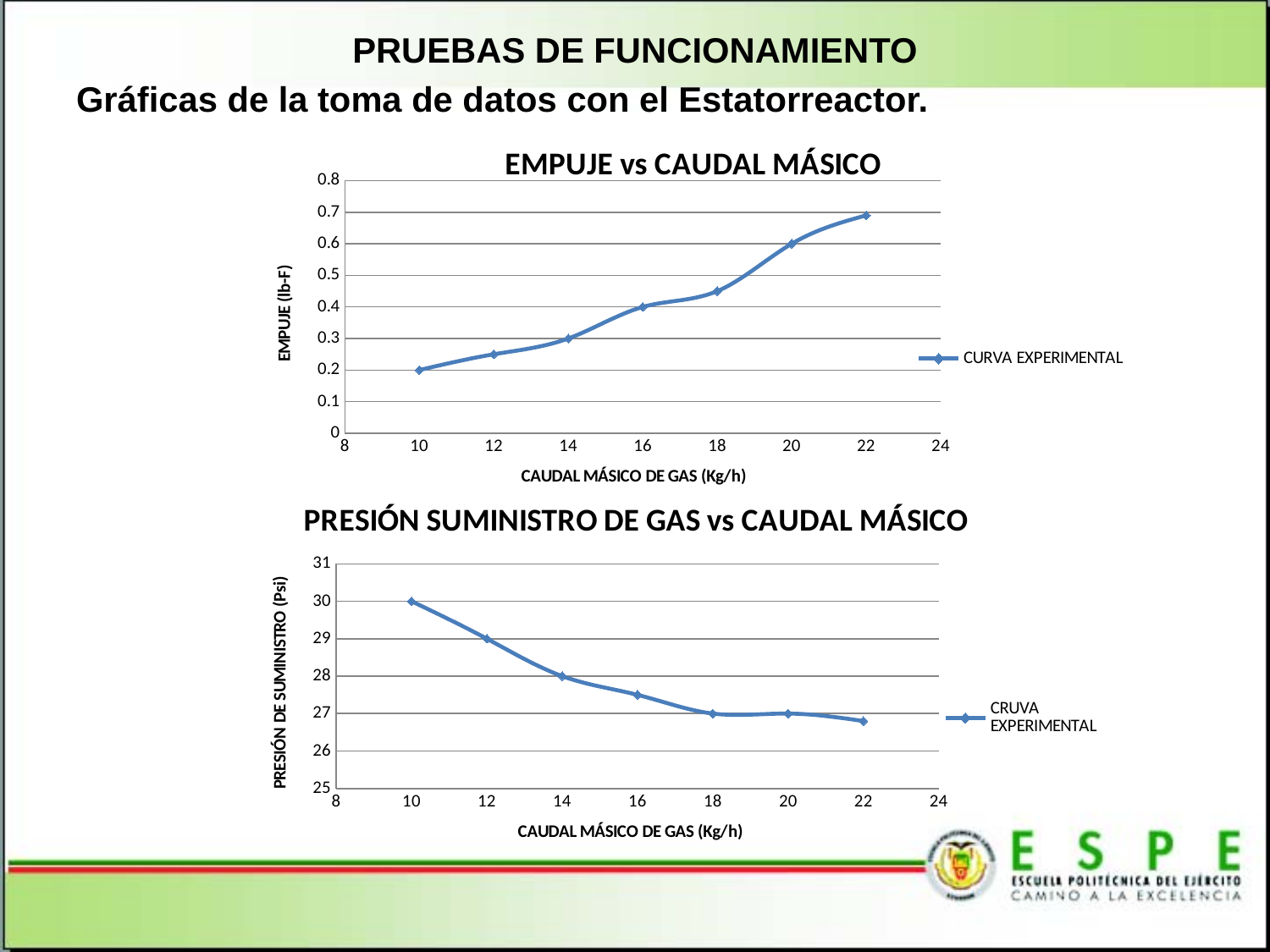
In the EMPUJE vs CAUDAL MÁSICO chart, is the value at 22 Kg/h greater or less than 0.6? greater In the EMPUJE vs CAUDAL MÁSICO chart, what is the EMPUJE value at a caudal másico of 10 Kg/h? 0.2 In the PRESIÓN SUMINISTRO DE GAS vs CAUDAL MÁSICO chart, how many series does the legend list? 1 In the EMPUJE vs CAUDAL MÁSICO chart, what type of chart is shown? line chart In the PRESIÓN SUMINISTRO DE GAS vs CAUDAL MÁSICO chart, at which caudal másico is the pressure highest? 10 In the EMPUJE vs CAUDAL MÁSICO chart, how many data points are plotted? 7 In the PRESIÓN SUMINISTRO DE GAS vs CAUDAL MÁSICO chart, what is the pressure at a caudal másico of 10 Kg/h? 30 In the PRESIÓN SUMINISTRO DE GAS vs CAUDAL MÁSICO chart, what is the pressure at a caudal másico of 14 Kg/h? 28 In the EMPUJE vs CAUDAL MÁSICO chart, what is the difference between the EMPUJE values at 20 Kg/h and 10 Kg/h? 0.4 In the EMPUJE vs CAUDAL MÁSICO chart, what is the EMPUJE value at a caudal másico of 20 Kg/h? 0.6 In the EMPUJE vs CAUDAL MÁSICO chart, do the values rise or fall as caudal másico increases? rise In the EMPUJE vs CAUDAL MÁSICO chart, what is the EMPUJE value at a caudal másico of 16 Kg/h? 0.4